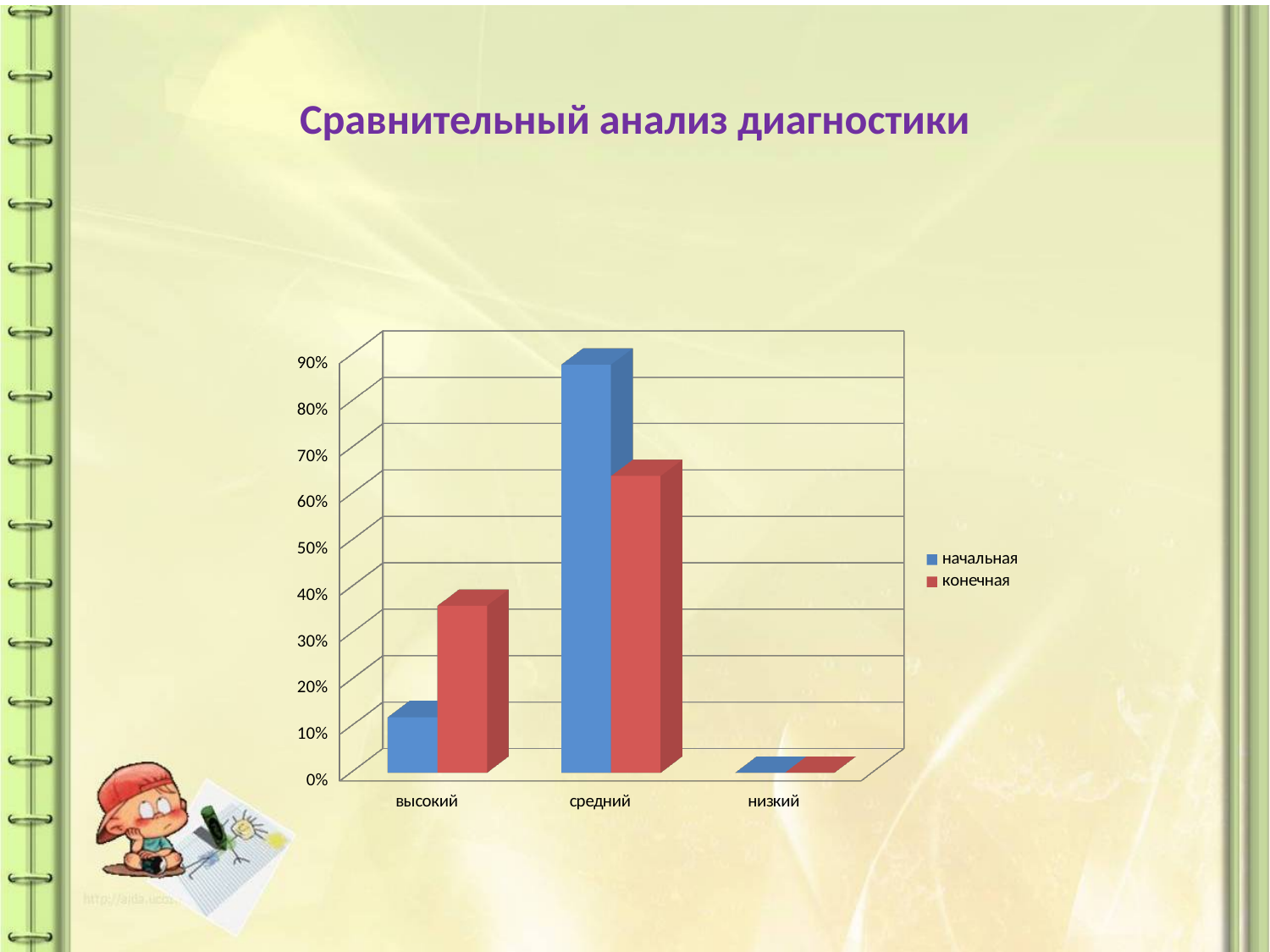
Which category has the highest value for the начальная series? средний For the category средний, which series has the larger value, начальная or конечная? начальная Which category has the lowest value for the конечная series? низкий How many series does the legend list? 2 What kind of chart is shown on the slide? bar chart Which colour represents the конечная series in the legend? red Is the начальная value for высокий greater or less than 20%? less What is the title of the chart on the slide? Сравнительный анализ диагностики Is the начальная value for средний greater or less than 80%? greater Is the конечная value for средний greater or less than 70%? less How many categories are shown on the x axis? 3 For the category высокий, which series has the larger value, начальная or конечная? конечная